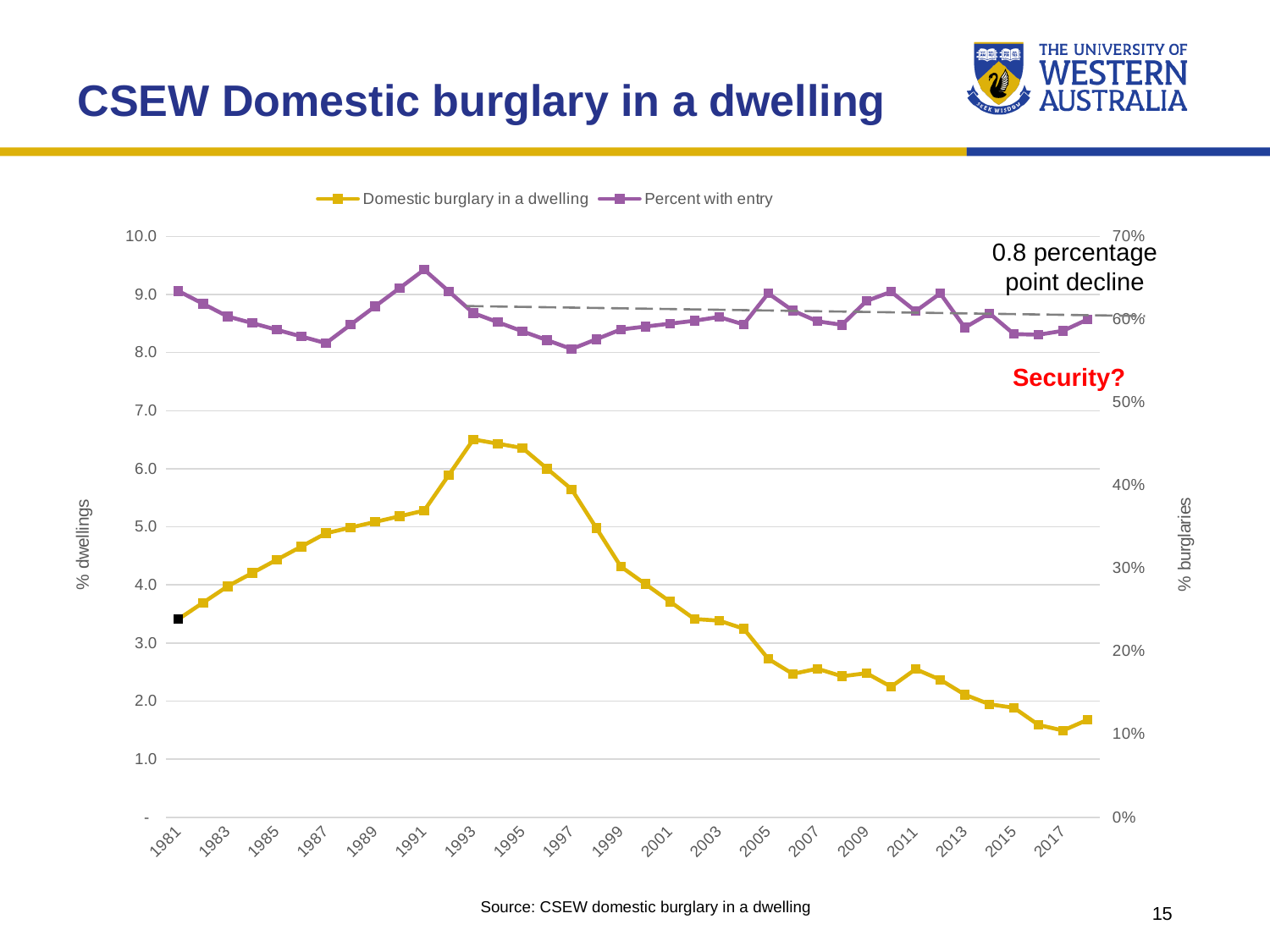
What kind of chart is shown on the slide? line chart Is the value for Percent with entry in 1997 greater or less than 60%? less What is the title of the left vertical axis? % dwellings Which is larger for Domestic burglary in a dwelling: the value in 1993 or the value in 2017? 1993 Does the Domestic burglary in a dwelling series rise or fall from 1993 to 2017? fall Is the value for Percent with entry in 1991 greater or less than 60%? greater Is the value for Domestic burglary in a dwelling in 1981 greater or less than 4.0? less How many series does the legend list? 2 What are the two series named in the legend? Domestic burglary in a dwelling; Percent with entry Does the Domestic burglary in a dwelling series rise or fall from 1981 to 1993? rise